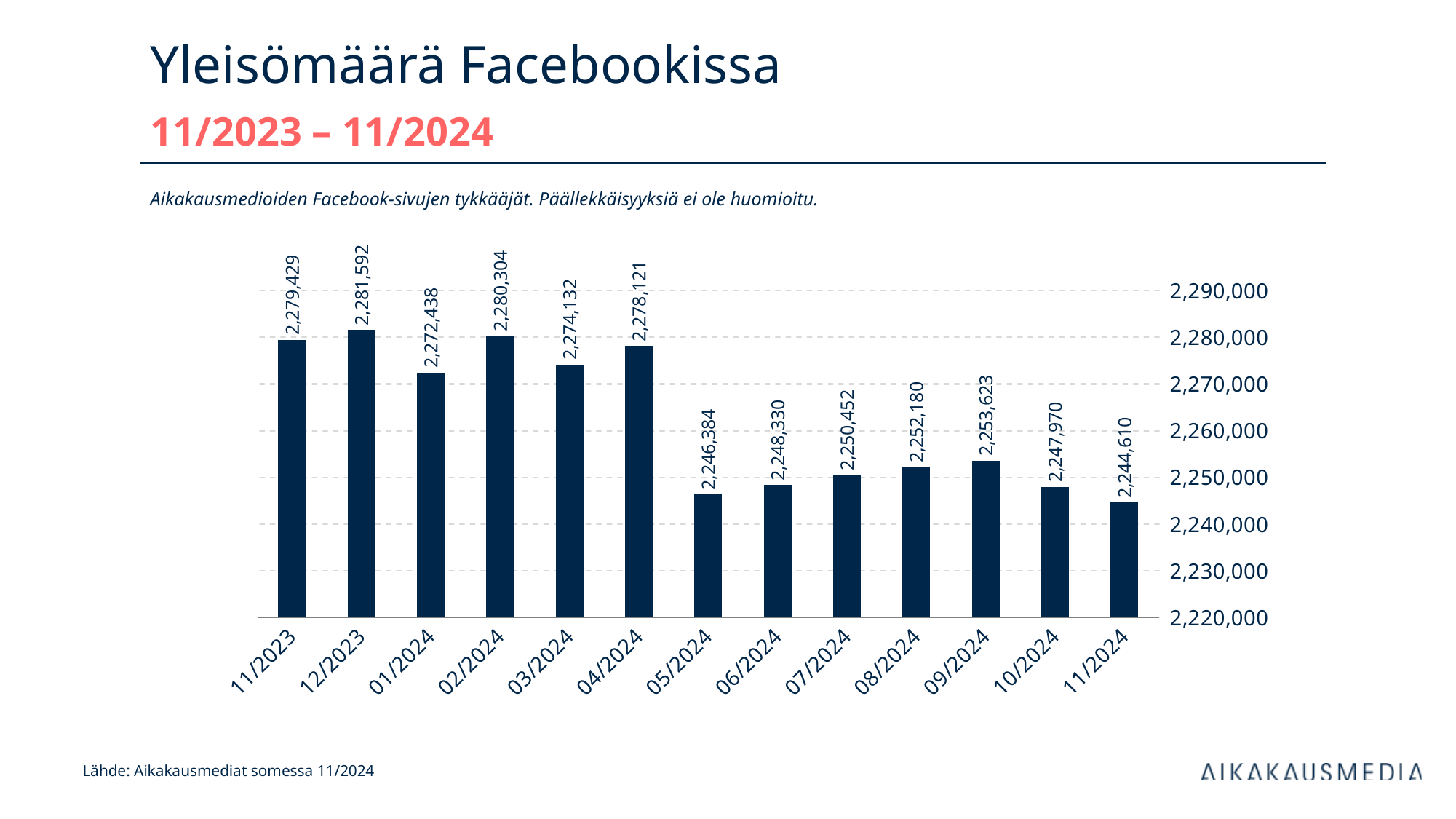
What kind of chart is shown on the slide? bar chart Which month has the lowest value? 11/2024 How many months are shown on the x axis? 13 Which month has the highest value? 12/2023 What is the difference between the values for 12/2023 and 11/2024? 36,982 What is the title of the chart on the slide? Yleisömäärä Facebookissa What is the value for 05/2024? 2,246,384 What is the value for 11/2024? 2,244,610 Is the value for 09/2024 greater or less than 2,260,000? less Which is larger, the value for 02/2024 or the value for 03/2024? 02/2024 What is the value for 11/2023? 2,279,429 What is the difference between the values for 11/2023 and 11/2024? 34,819